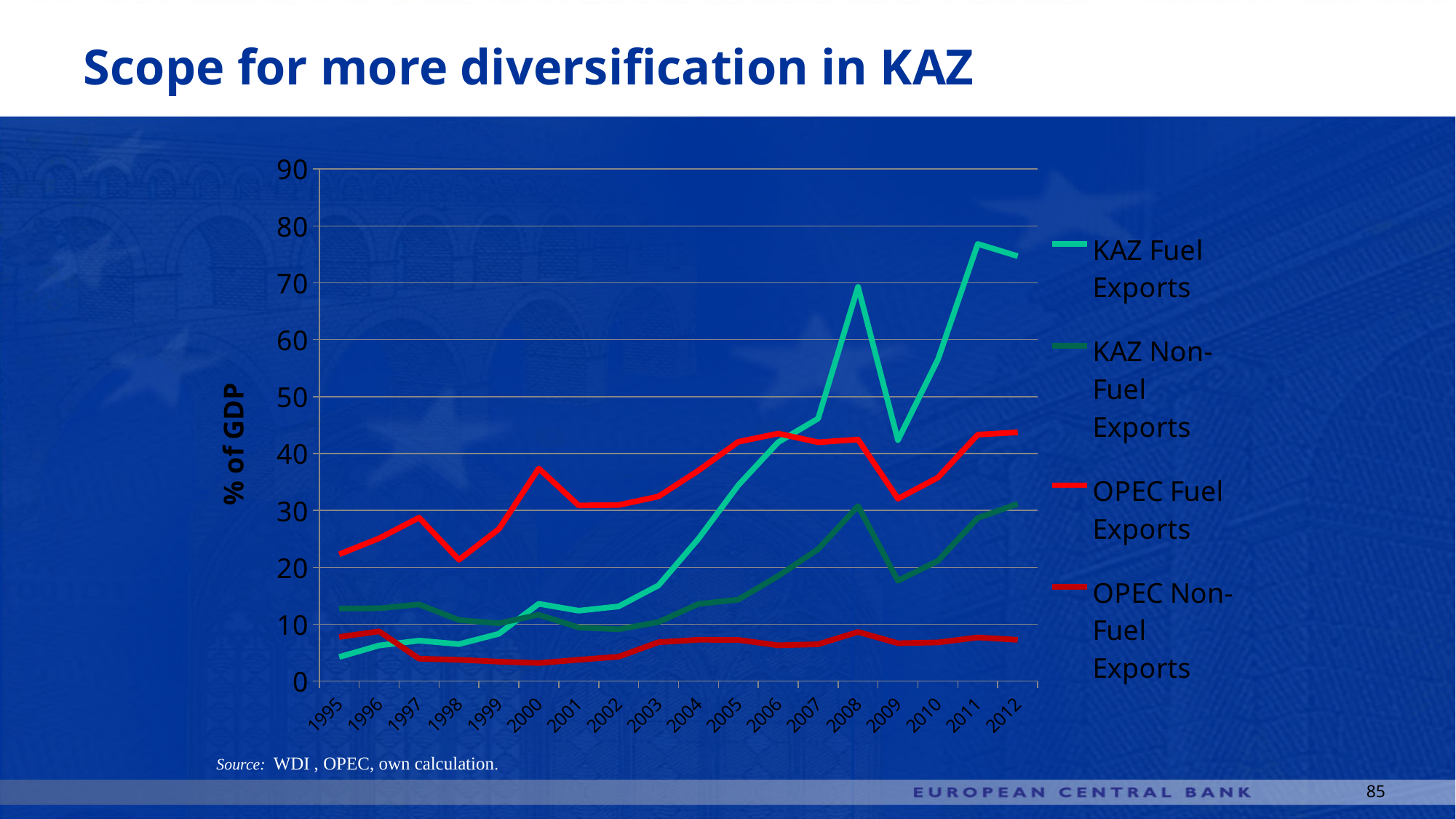
Which series has the lowest value in 2012? OPEC Non-Fuel Exports Is the value for OPEC Fuel Exports in 2006 greater or less than 40? greater Is the value for KAZ Fuel Exports in 1995 greater or less than 10? less Do the values for KAZ Fuel Exports overall rise or fall from 1995 to 2012? rise How many years are shown along the x axis? 18 What kind of chart is shown on the slide? Line chart Is the value for OPEC Non-Fuel Exports in 2012 greater or less than 10? less Which series has the highest value in 2012? KAZ Fuel Exports What is the label of the y axis? % of GDP In 2000, which is larger: OPEC Fuel Exports or KAZ Fuel Exports? OPEC Fuel Exports How many series does the legend list? 4